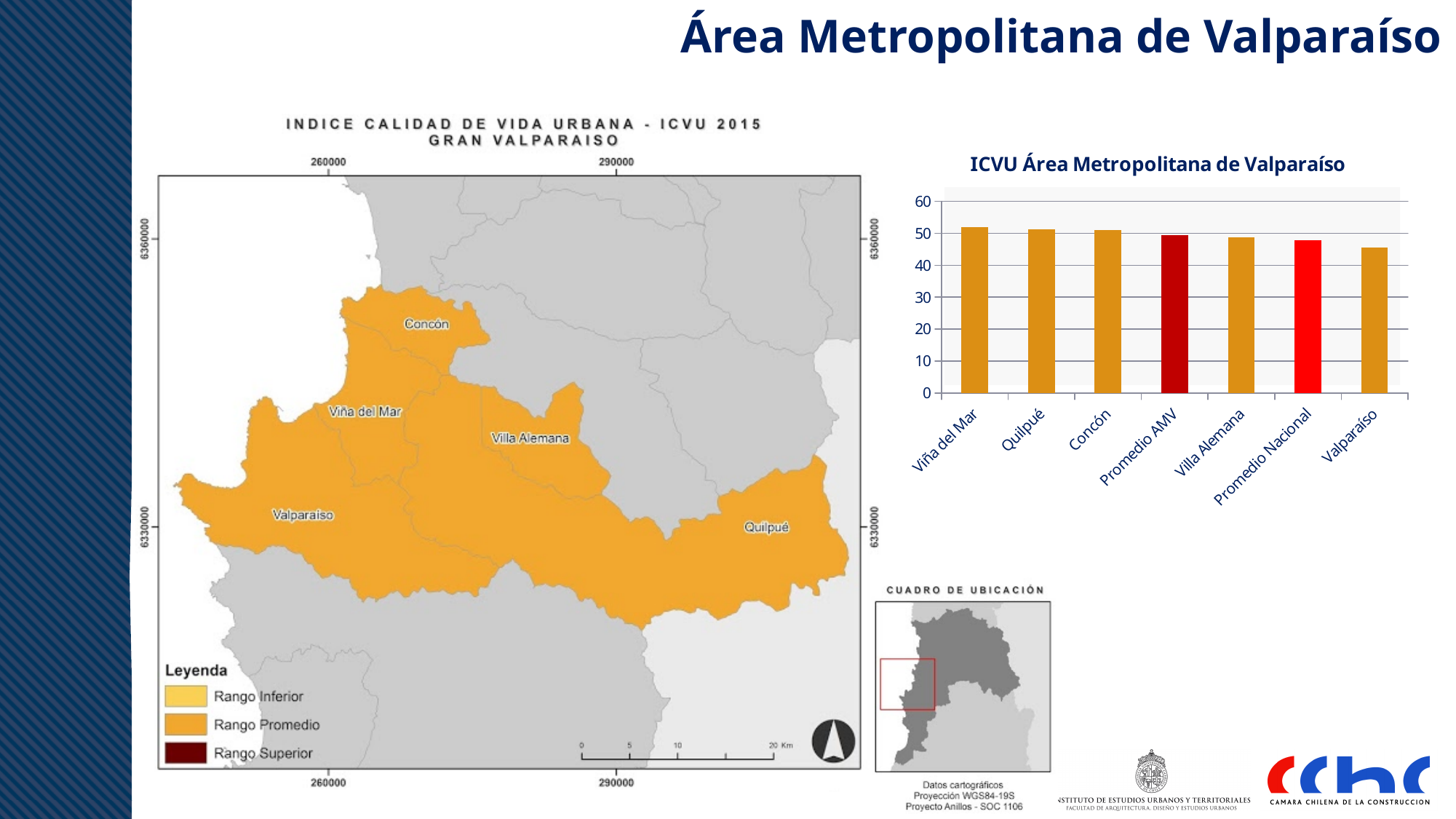
In the 'ICVU Área Metropolitana de Valparaíso' chart, is the value for Valparaíso greater or less than 50? less What kind of chart is the 'ICVU Área Metropolitana de Valparaíso' chart? bar chart In the 'ICVU Área Metropolitana de Valparaíso' chart, is the value for Valparaíso greater or less than 40? greater What is the title of the bar chart on the right side of the slide? ICVU Área Metropolitana de Valparaíso In the 'ICVU Área Metropolitana de Valparaíso' chart, which is larger, the value for Concón or the value for Promedio Nacional? Concón In the 'ICVU Área Metropolitana de Valparaíso' chart, is the value for Promedio Nacional greater or less than 50? less How many bars are shown in the 'ICVU Área Metropolitana de Valparaíso' chart? 7 In the 'ICVU Área Metropolitana de Valparaíso' chart, which is larger, the value for Viña del Mar or the value for Valparaíso? Viña del Mar In the 'ICVU Área Metropolitana de Valparaíso' chart, which category has the lowest value? Valparaíso In the 'ICVU Área Metropolitana de Valparaíso' chart, what colour is the bar for Promedio Nacional? red In the 'ICVU Área Metropolitana de Valparaíso' chart, do the values generally rise or fall from left to right along the x axis? fall